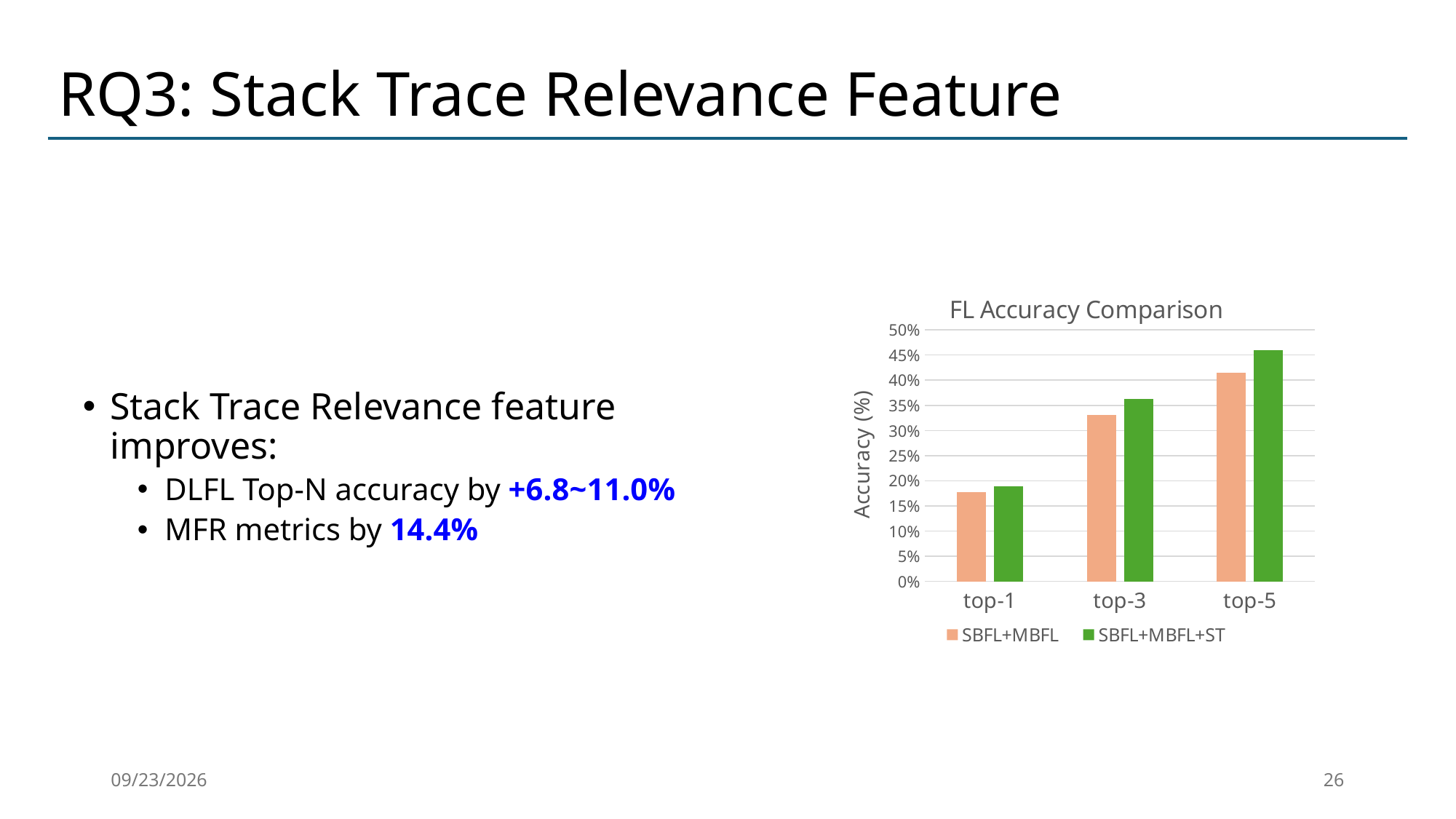
Is the value for SBFL+MBFL+ST at top-5 greater or less than 40%? greater What is the title of the chart? FL Accuracy Comparison Do the SBFL+MBFL+ST values rise or fall from top-1 to top-5? rise Which category and series has the highest bar in the chart? top-5, SBFL+MBFL+ST Which series is shown in green in the chart? SBFL+MBFL+ST Is the value for SBFL+MBFL at top-1 greater or less than 20%? less What type of chart is shown on the slide? bar chart How many series does the chart's legend list? 2 At top-5, which series has the larger value, SBFL+MBFL or SBFL+MBFL+ST? SBFL+MBFL+ST Which category and series has the lowest bar in the chart? top-1, SBFL+MBFL How many categories are shown on the x axis of the chart? 3 Is the value for SBFL+MBFL at top-3 greater or less than 30%? greater